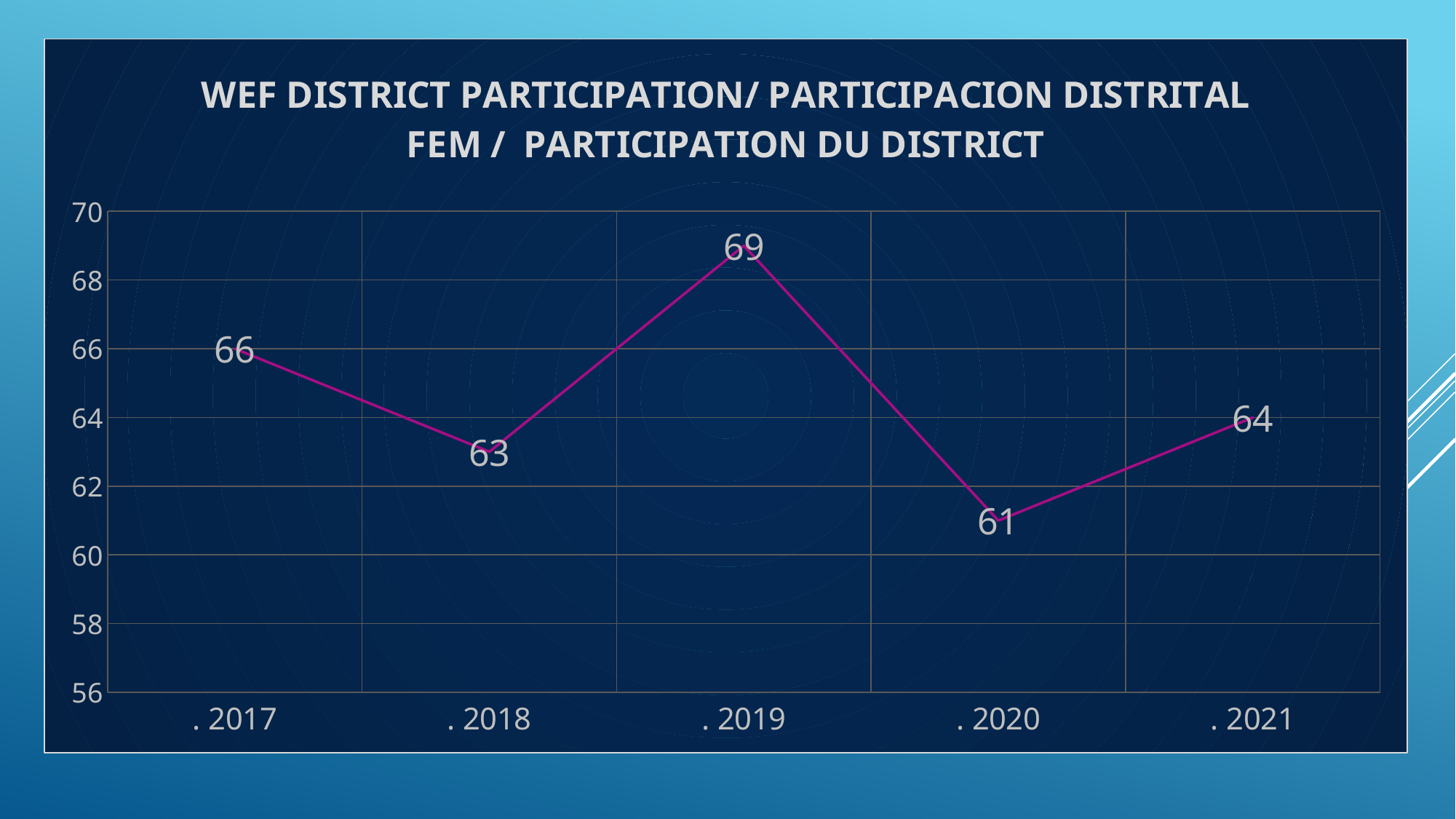
Is the value for 2020 greater or less than 62? less What is the difference between the values for 2019 and 2020? 8 What is the value for 2017? 66 Does the value rise or fall from 2020 to 2021? rise What is the difference between the values for 2017 and 2018? 3 How many years are plotted on the chart? 5 What kind of chart is shown on the slide? line chart Which year has the lowest value? 2020 Which year has the highest value? 2019 What is the value for 2019? 69 What is the value for 2021? 64 Which is larger, the value for 2018 or the value for 2021? 2021